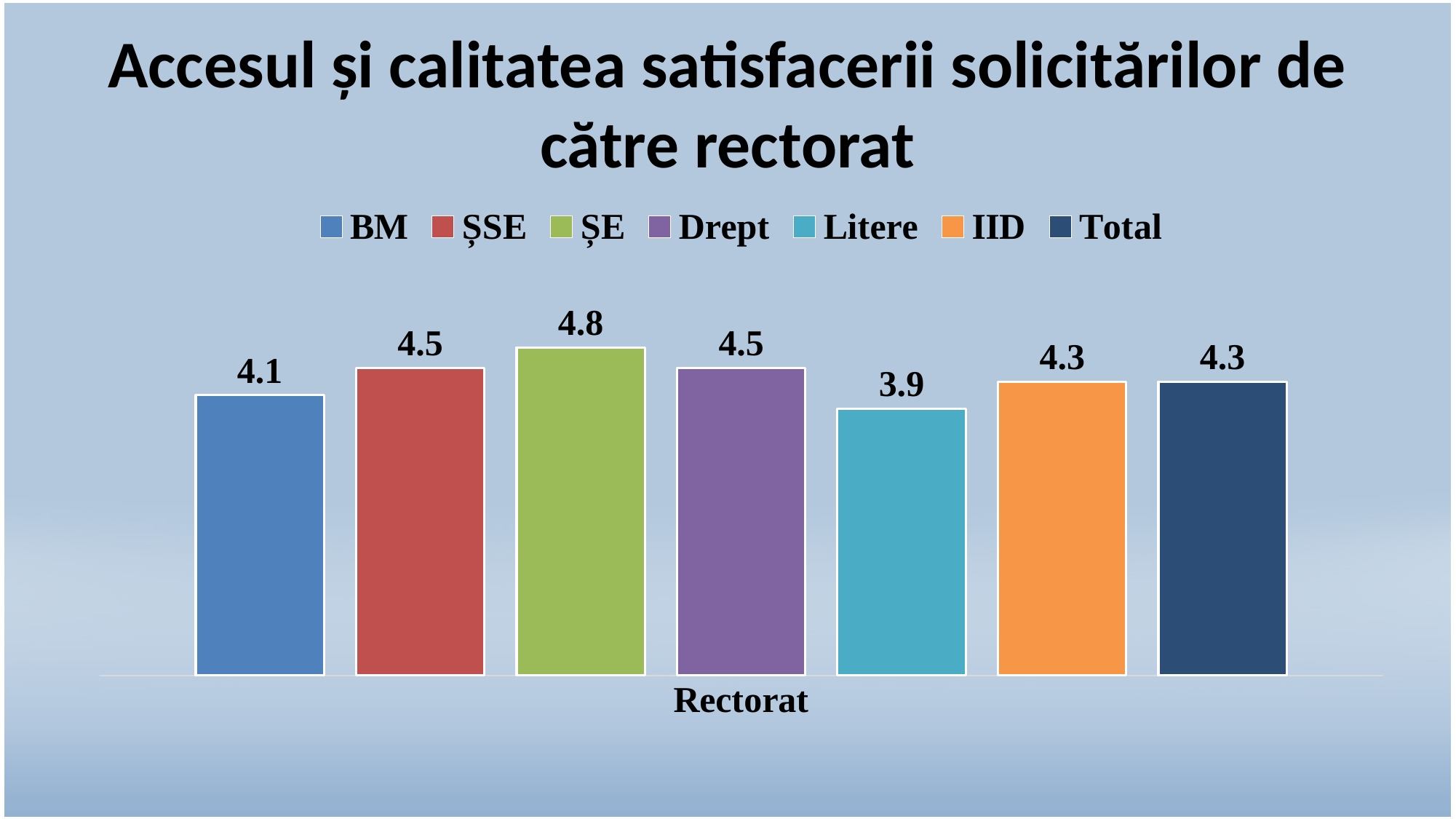
What is the value for Litere? 3.9 What is the difference between the values for ȘSE and BM? 0.4 What kind of chart is shown on the slide? Bar chart Which is larger, the value for Drept or the value for IID? Drept Which series has the highest value? ȘE What is the value for Total? 4.3 What is the label on the x axis of the chart? Rectorat Which series has the lowest value? Litere How many series does the legend list? 7 What is the value for BM? 4.1 What is the value for ȘE? 4.8 What is the difference between the values for ȘE and Litere? 0.9